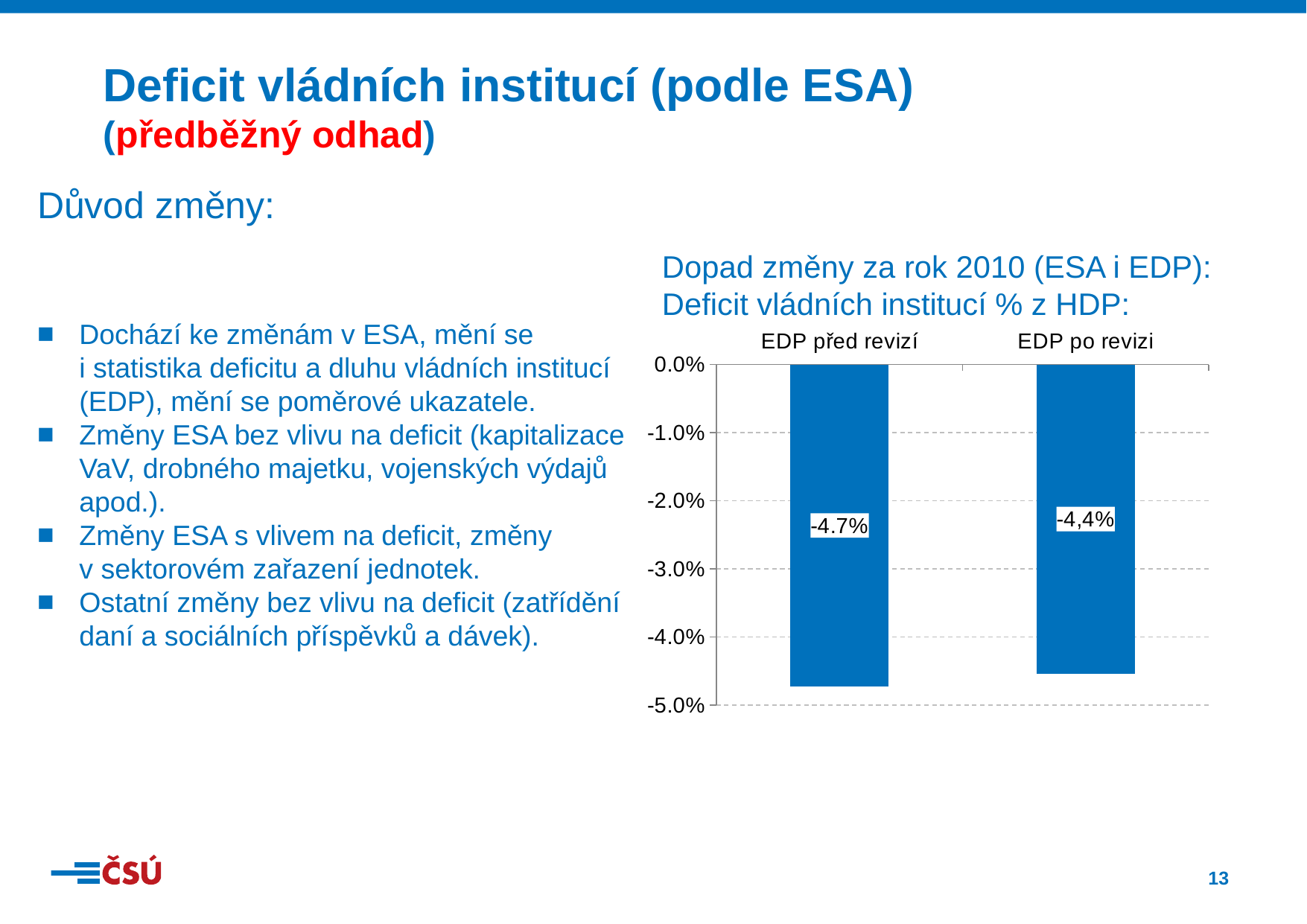
Which category has the lowest (most negative) value? EDP před revizí Which category has the highest (least negative) value? EDP po revizi What is the difference in percentage points between the EDP před revizí and EDP po revizi values? 0.3 Do the values rise or fall from the left bar to the right bar? rise What is the value shown for EDP před revizí? -4.7% Is the value for EDP po revizi greater or less than -4.0%? less Is the value for EDP před revizí greater or less than -5.0%? greater What colour are the bars in the chart? blue What is the value shown for EDP po revizi? -4,4% How many bars are plotted in the chart? 2 What kind of chart is shown on the slide? bar chart Which bar extends further below zero, EDP před revizí or EDP po revizi? EDP před revizí